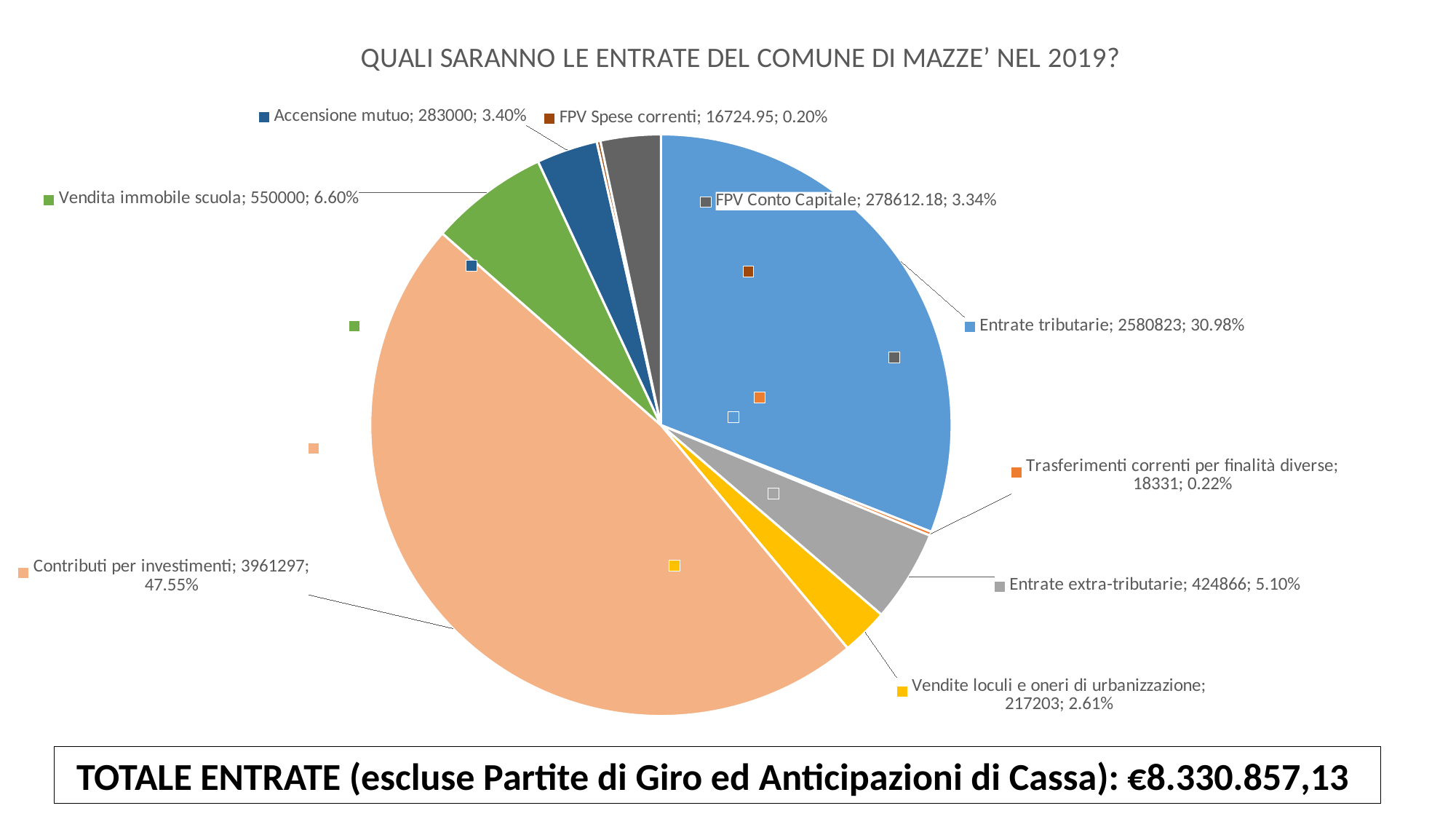
Which category has the smallest slice of the pie? FPV Spese correnti What is the value for FPV Conto Capitale? 278612.18 What is the difference between the values for Entrate tributarie and Entrate extra-tributarie? 2155957 What is the title of the chart? QUALI SARANNO LE ENTRATE DEL COMUNE DI MAZZE' NEL 2019? How many slices does the pie chart have? 9 What share of the pie does Vendita immobile scuola represent? 6.60% What share of the pie does Entrate extra-tributarie represent? 5.10% What kind of chart is shown on the slide? pie chart Which category has the largest slice of the pie? Contributi per investimenti What is the value for Vendite loculi e oneri di urbanizzazione? 217203 What is the value for Entrate tributarie? 2580823 Which is larger, the value for Accensione mutuo or the value for FPV Conto Capitale? Accensione mutuo